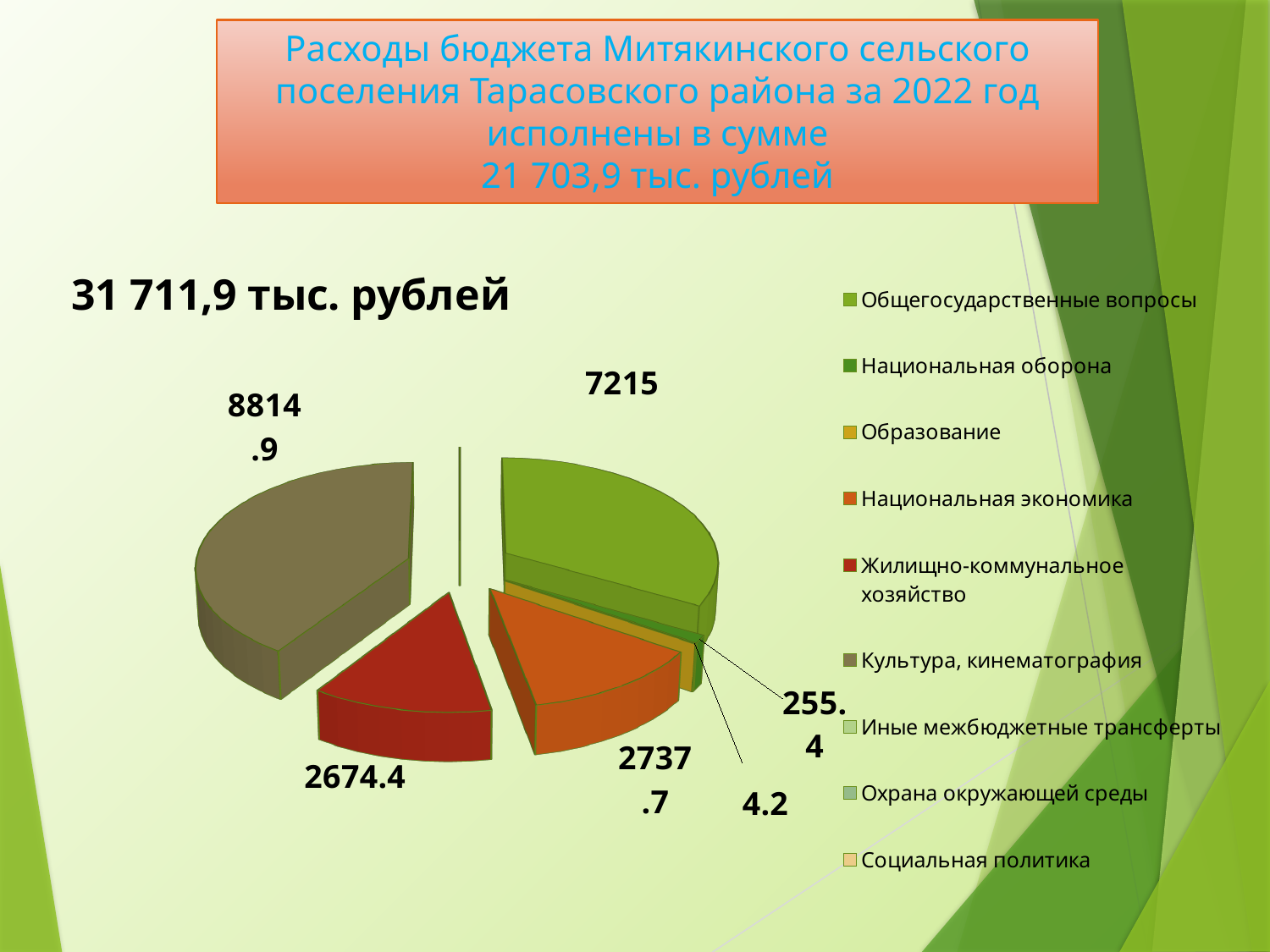
What type of chart is shown on the slide? pie chart What is the value shown for Национальная экономика? 2737.7 What is the value shown for Жилищно-коммунальное хозяйство? 2674.4 What is the value shown for Общегосударственные вопросы? 7215 What is the value shown for Национальная оборона? 255.4 Which is larger: the value for Национальная экономика or for Жилищно-коммунальное хозяйство? Национальная экономика How many entries does the legend list? 9 What is the value shown for Культура, кинематография? 8814.9 Which labelled category has the smallest value? Образование Which category has the largest slice of the pie? Культура, кинематография What is the difference between the values for Культура, кинематография and Общегосударственные вопросы? 1599.9 How many slices in the pie have a data label? 6